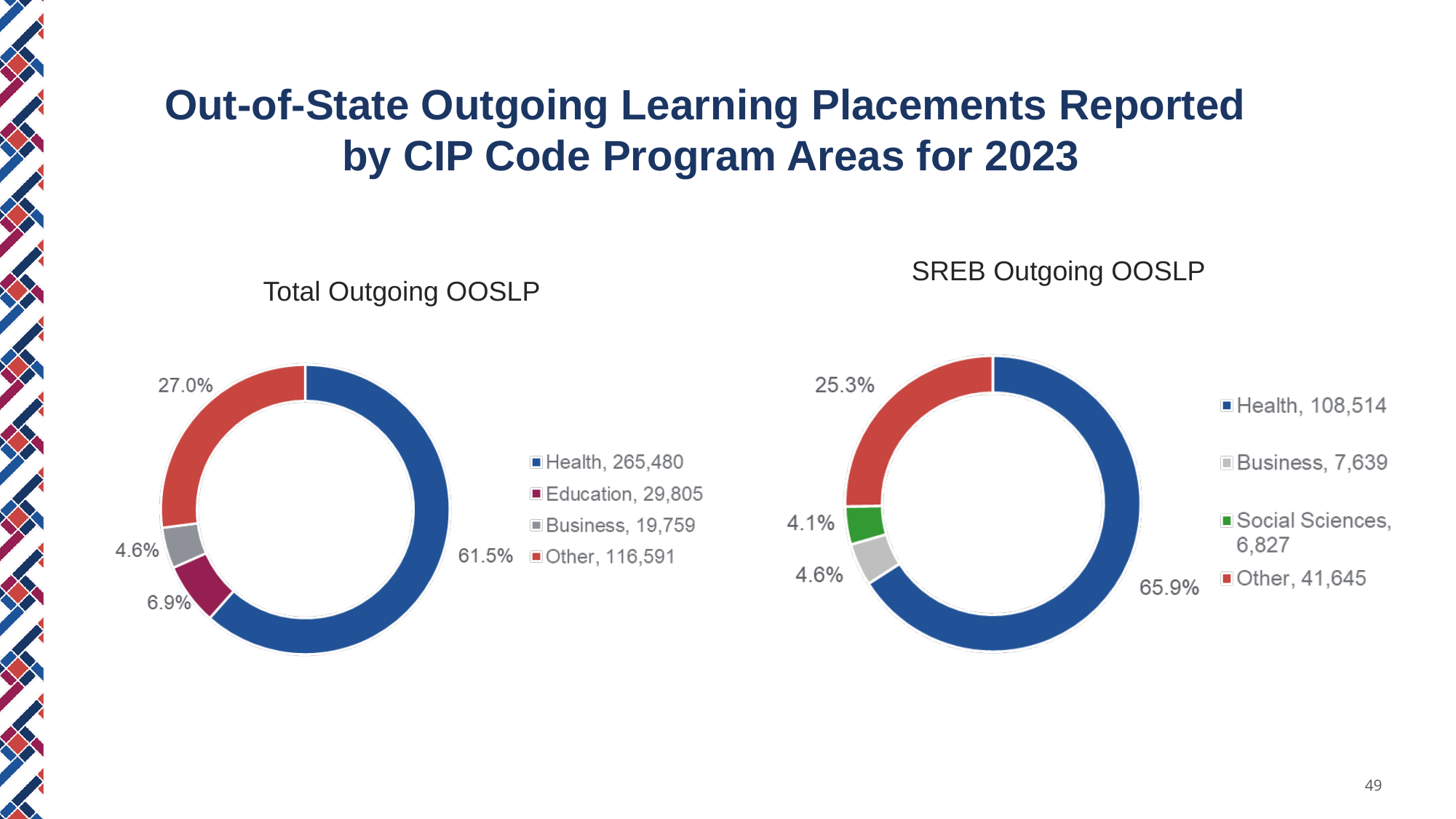
In the SREB Outgoing OOSLP chart, what is the value for Health? 108,514 In the Total Outgoing OOSLP chart, what share of the donut does Other represent? 27.0% What kind of chart is the Total Outgoing OOSLP chart? Donut (pie) chart How many categories does the legend of the SREB Outgoing OOSLP chart list? 4 In the Total Outgoing OOSLP chart, what is the value for Education? 29,805 In the SREB Outgoing OOSLP chart, what share of the donut does Health represent? 65.9% In the SREB Outgoing OOSLP chart, which category has the smallest value? Social Sciences In the Total Outgoing OOSLP chart, what is the difference between the Education and Business values? 10,046 In the SREB Outgoing OOSLP chart, which is larger, Business or Social Sciences? Business In the SREB Outgoing OOSLP chart, what colour is the Social Sciences slice? Green In the Total Outgoing OOSLP chart, what is the value for Health? 265,480 In the Total Outgoing OOSLP chart, which category has the smallest value? Business